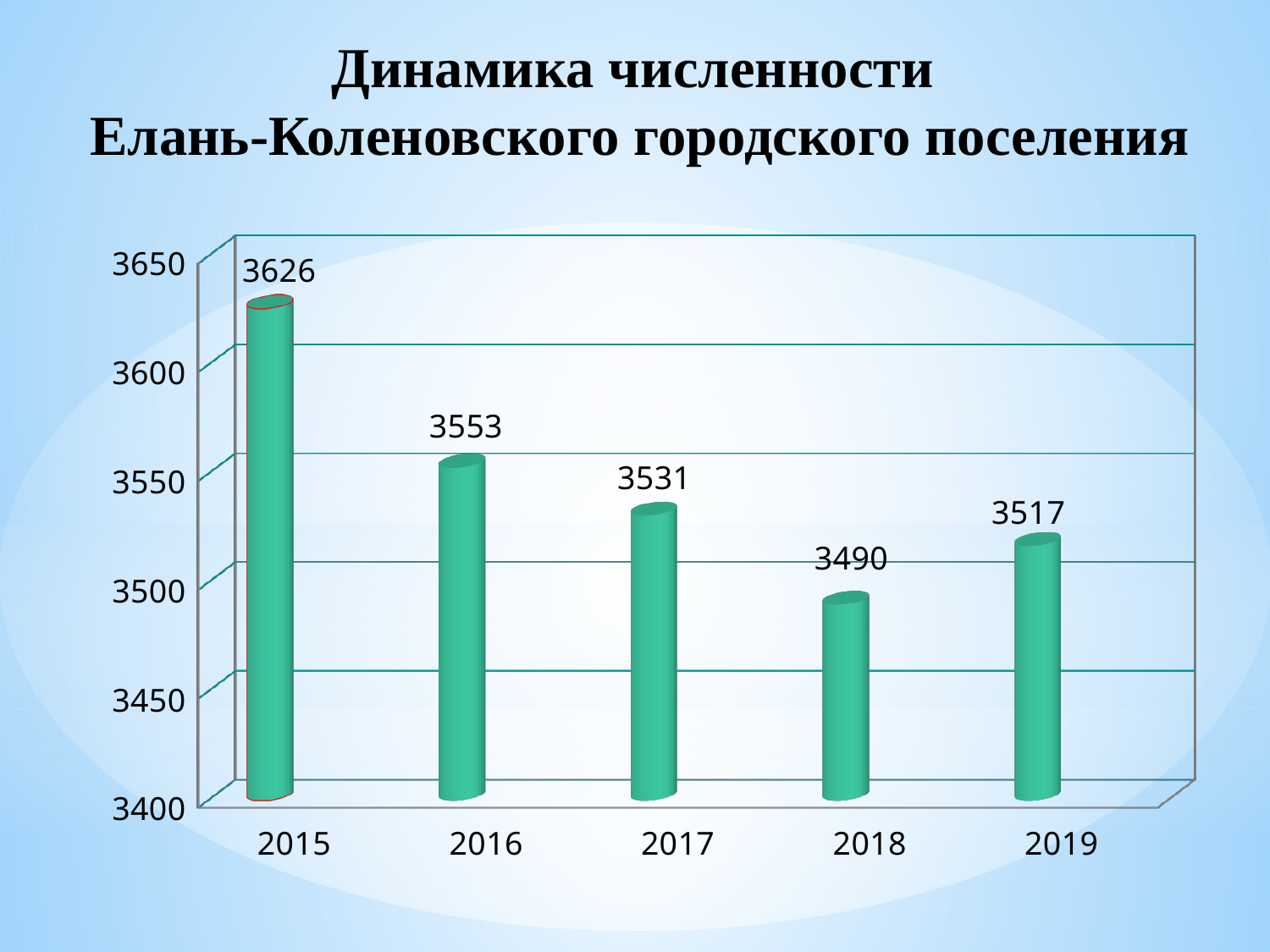
What is the population value shown for 2015? 3626 Do the values generally rise or fall from 2015 to 2018? fall Which is larger, the value for 2017 or the value for 2019? 2017 Which year has the lowest value? 2018 What kind of chart is shown on the slide? bar chart Which year has the highest value? 2015 How many years are shown on the x axis? 5 What is the population value shown for 2019? 3517 What is the difference between the values for 2016 and 2017? 22 What is the population value shown for 2018? 3490 Is the value for 2018 greater or less than 3500? less What is the difference between the values for 2015 and 2019? 109